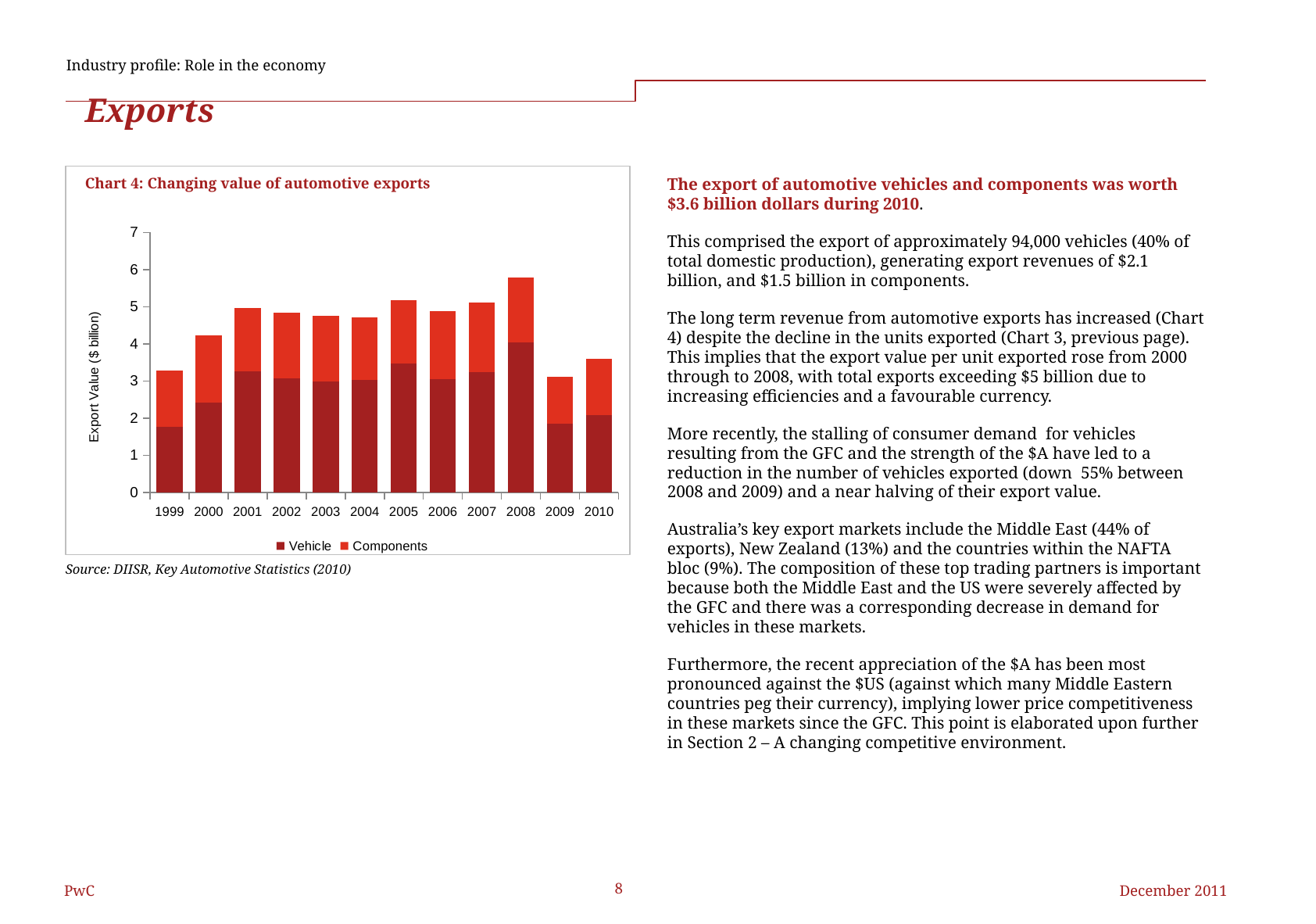
Is the total export value for 2010 greater or less than 4? less Does the total export value rise or fall from 2008 to 2009? Fall What kind of chart is Chart 4? Stacked bar chart How many years are shown on the x axis of Chart 4? 12 Which year has the highest total export value in Chart 4? 2008 Is the total export value for 2008 greater or less than 5? greater Which year has the larger total export value, 2008 or 2009? 2008 Is the Vehicle export value for 1999 greater or less than 2? less What is the label on the y axis of Chart 4? Export Value ($ billion) What is the title of the chart on the slide? Chart 4: Changing value of automotive exports How many series does the legend of Chart 4 list? 2